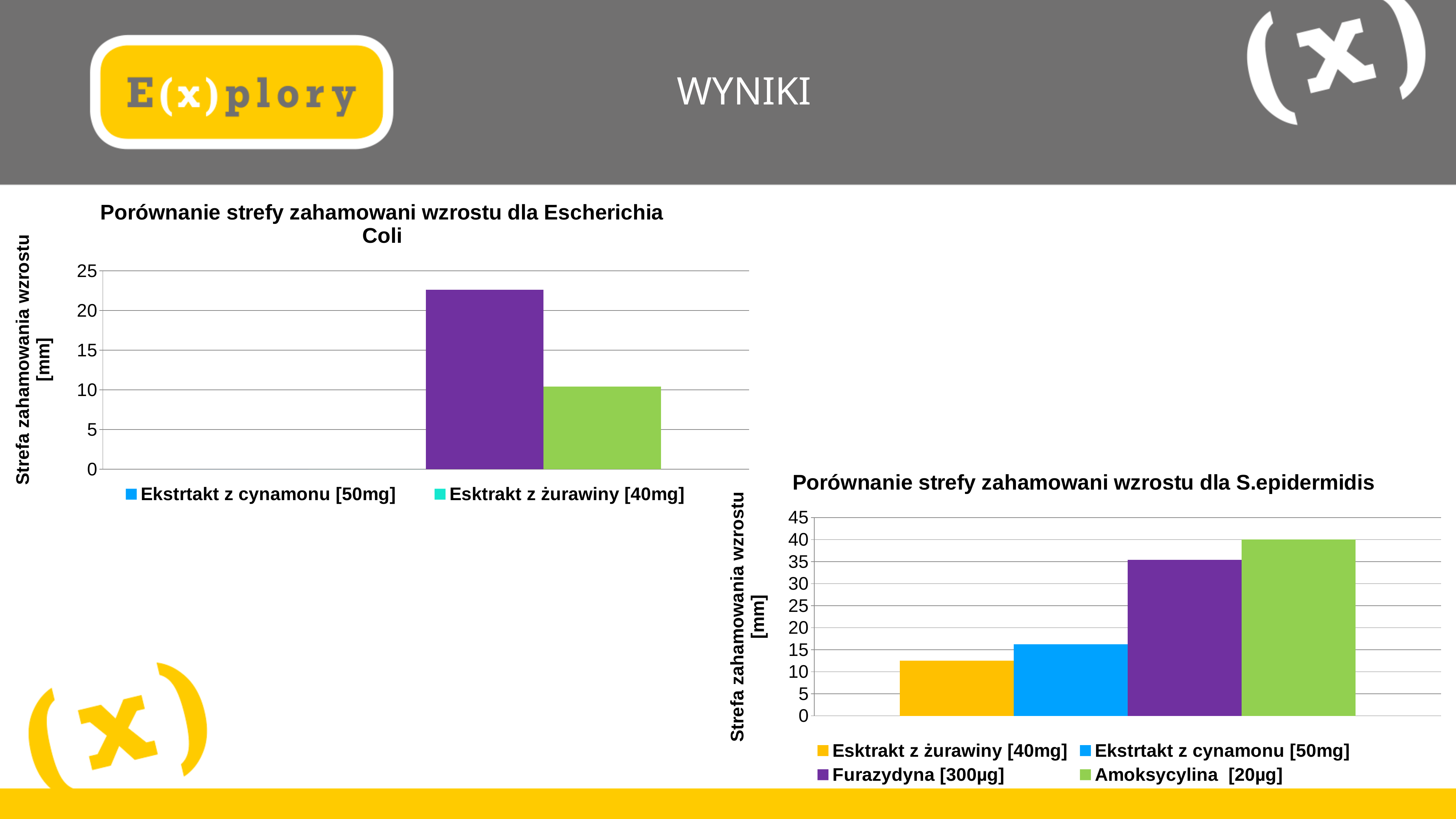
In the chart titled 'Porównanie strefy zahamowani wzrostu dla S.epidermidis', is the value for Ekstrtakt z cynamonu [50mg] greater or less than 20? less In the chart titled 'Porównanie strefy zahamowani wzrostu dla Escherichia Coli', how many entries does the legend list? 2 In the chart titled 'Porównanie strefy zahamowani wzrostu dla S.epidermidis', is the value for Furazydyna [300µg] greater or less than 30? greater In the chart titled 'Porównanie strefy zahamowani wzrostu dla S.epidermidis', which series has the lowest value? Esktrakt z żurawiny [40mg] In the chart titled 'Porównanie strefy zahamowani wzrostu dla Escherichia Coli', is the purple bar greater or less than 20? greater In the chart titled 'Porównanie strefy zahamowani wzrostu dla S.epidermidis', which is larger: Furazydyna [300µg] or Ekstrtakt z cynamonu [50mg]? Furazydyna [300µg] In the chart titled 'Porównanie strefy zahamowani wzrostu dla S.epidermidis', how many series does the legend list? 4 What kind of chart is the chart titled 'Porównanie strefy zahamowani wzrostu dla S.epidermidis'? bar chart What is the y-axis label of the chart titled 'Porównanie strefy zahamowani wzrostu dla S.epidermidis'? Strefa zahamowania wzrostu [mm] In the chart titled 'Porównanie strefy zahamowani wzrostu dla S.epidermidis', which series has the highest value? Amoksycylina [20µg]